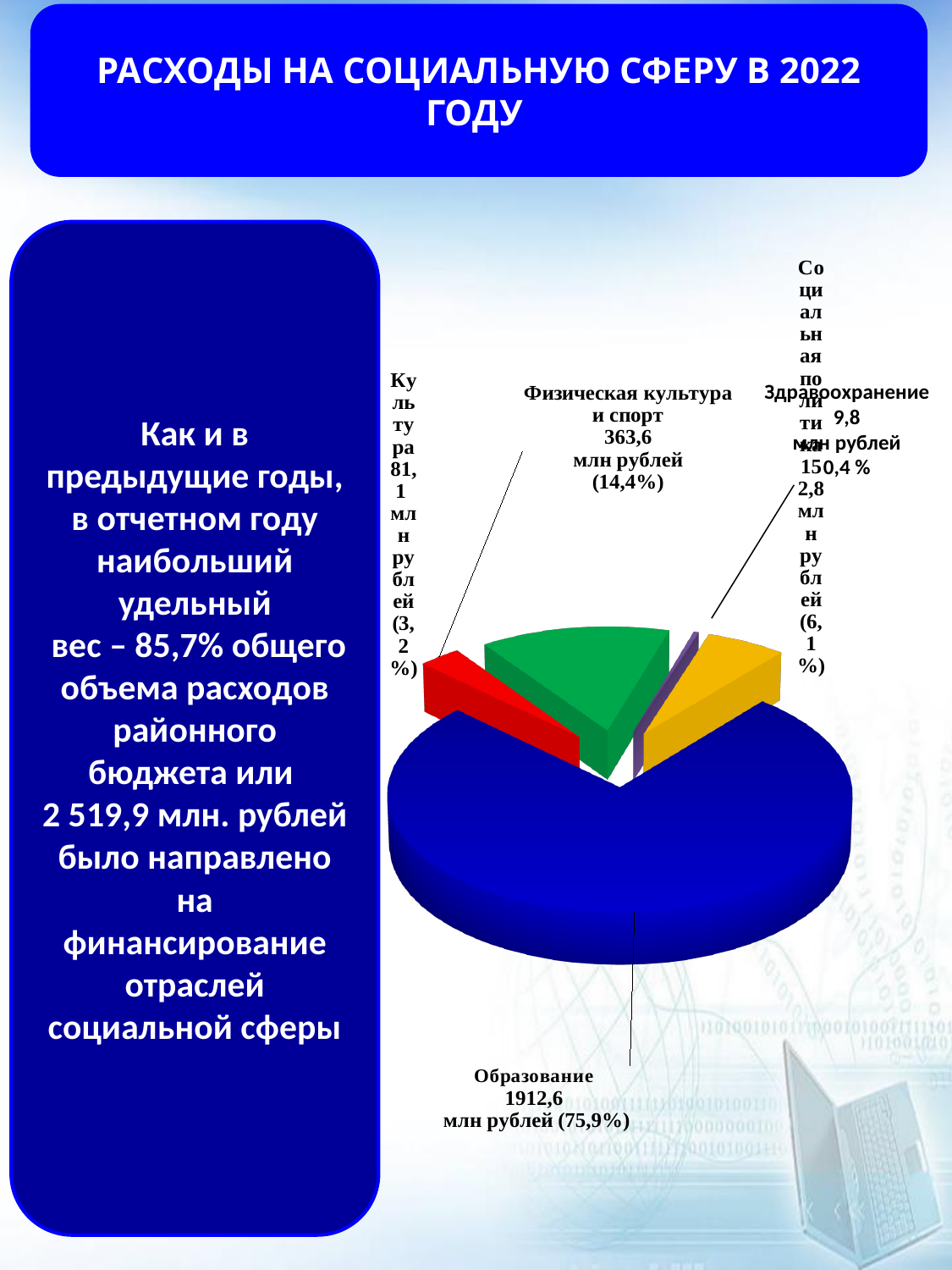
Which is larger: the value for Физическая культура и спорт or the value for Культура? Физическая культура и спорт What is the difference between the values for Образование and Физическая культура и спорт? 1549,0 млн рублей What is the value shown for Образование? 1912,6 млн рублей What share of the pie does Культура account for? 3,2% What share of the pie does Физическая культура и спорт account for? 14,4% Which category has the largest share of the pie chart? Образование What kind of chart is shown on the slide? Pie chart What is the value shown for Культура? 81,1 млн рублей How many categories (slices) does the pie chart show? 5 What share of the pie does Образование account for? 75,9% What colour is the Образование slice of the pie chart? Blue What is the value shown for Физическая культура и спорт? 363,6 млн рублей